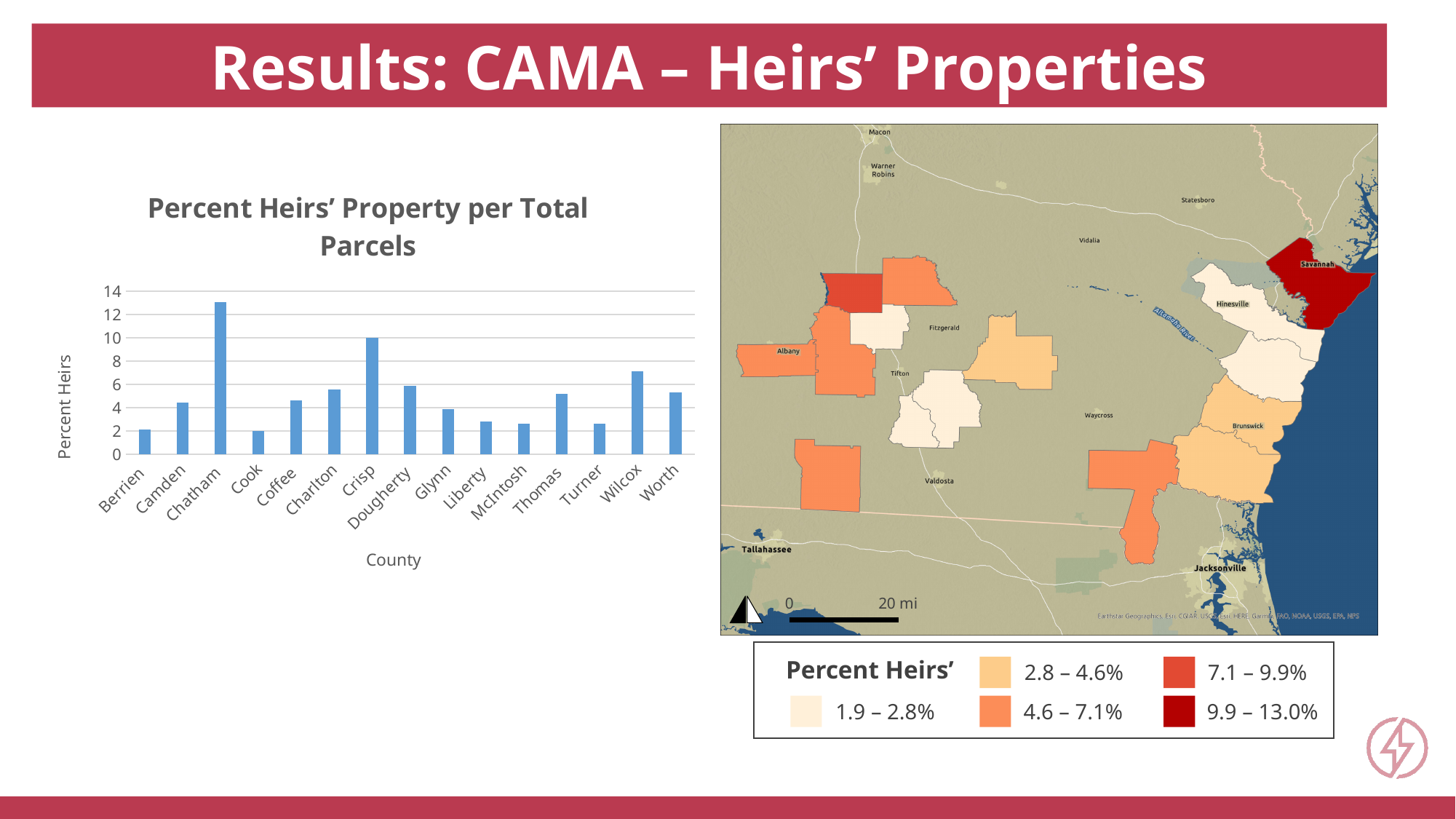
What is the label on the y axis of the bar chart? Percent Heirs In the bar chart, which is larger, the value for Chatham or the value for Crisp? Chatham How many counties are shown on the x axis of the bar chart? 15 What type of chart is 'Percent Heirs' Property per Total Parcels'? bar chart How many percent ranges does the map legend 'Percent Heirs'' list? 5 In the bar chart, which county has the highest percent of heirs' property? Chatham In the bar chart, is the value for Liberty greater or less than 4? less In the bar chart, which is larger, the value for Wilcox or the value for Worth? Wilcox In the bar chart, is the value for Chatham greater or less than 12? greater In the bar chart, is the value for Wilcox greater or less than 6? greater